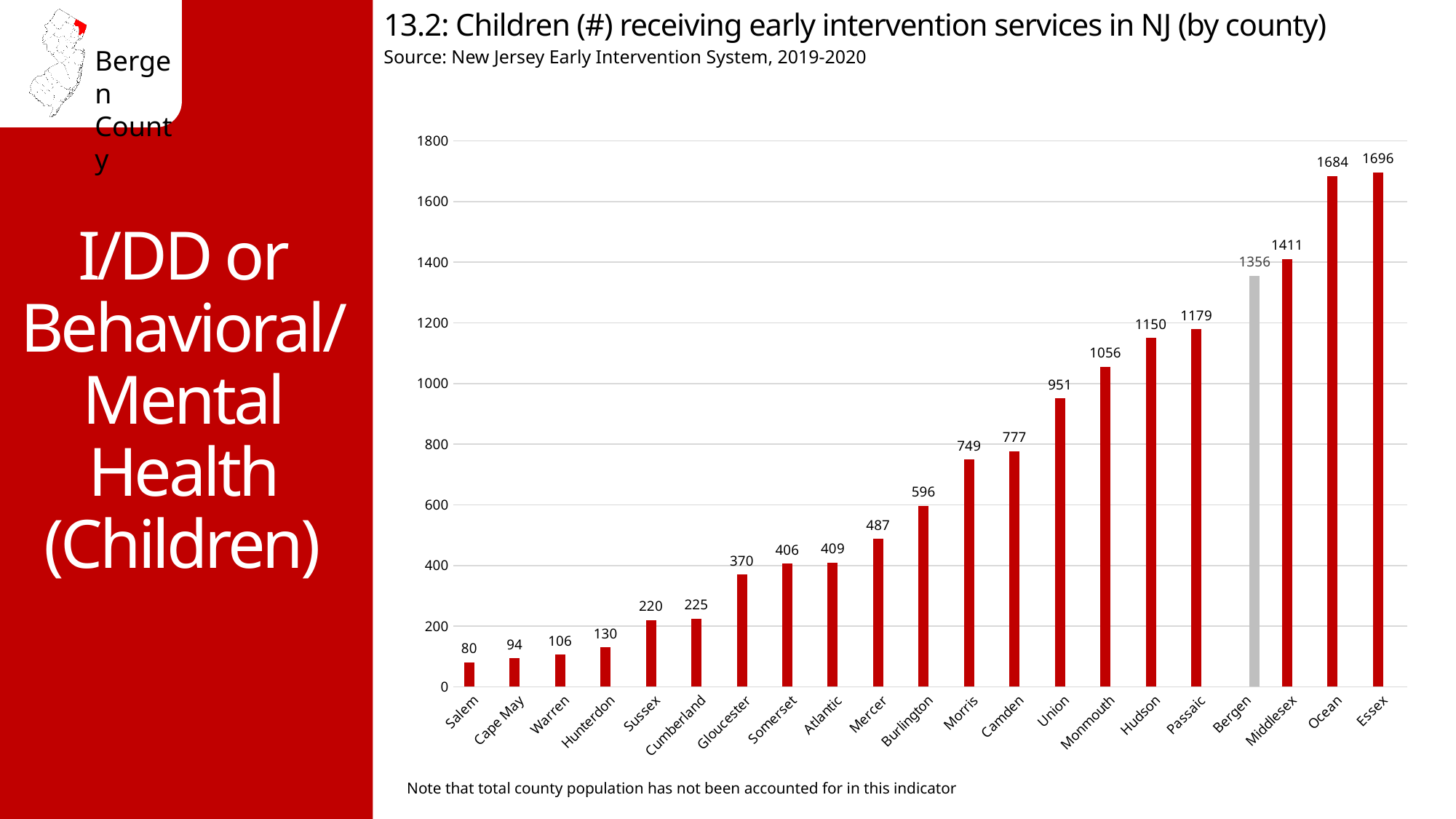
How many counties are shown on the x axis? 21 What is the difference between the values for Middlesex and Passaic? 232 Which has a larger value, Union or Camden? Union What is the value shown for Hudson? 1150 Which county has the highest number of children receiving early intervention services? Essex What is the value shown for Gloucester? 370 Is the value for Monmouth greater or less than 1000? greater Which county has the lowest number of children receiving early intervention services? Salem How many children received early intervention services in Bergen County? 1356 What is the difference between the values for Essex and Bergen? 340 What kind of chart is shown on the slide? Bar chart Do the values rise or fall moving from left to right along the x axis? Rise